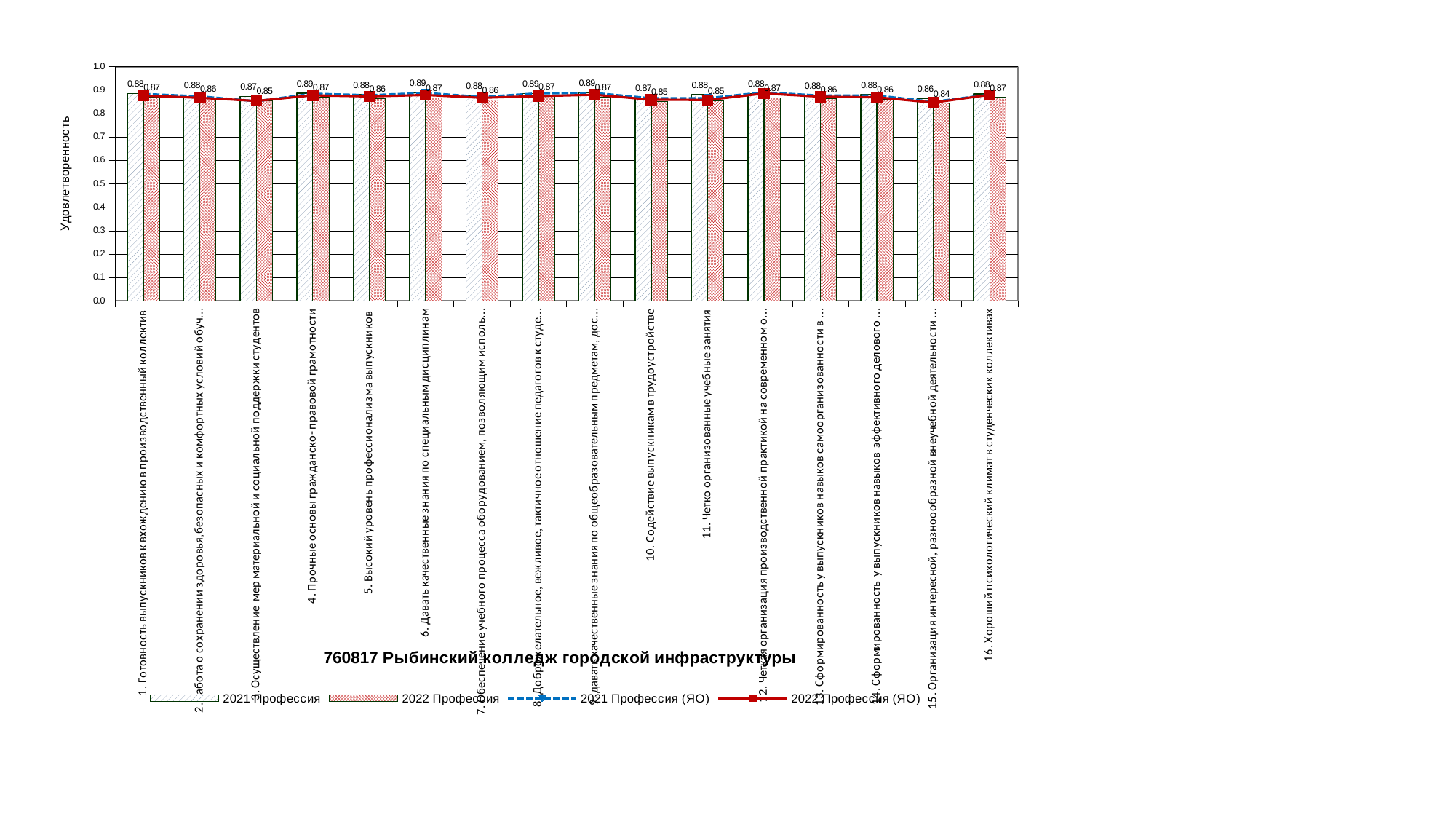
For "3. Осуществление мер материальной и социальной поддержки студентов", what is the difference between the 2021 Профессия and 2022 Профессия values? 0.02 What kind of chart is shown on the slide? A combined bar and line chart How many categories are plotted along the x axis? 16 What is the 2022 Профессия value for "10. Содействие выпускникам в трудоустройстве"? 0.85 How many series does the legend list? 4 What is the 2021 Профессия value for "4. Прочные основы гражданско-правовой грамотности"? 0.89 Is the 2021 Профессия value for "5. Высокий уровень профессионализма выпускников" greater or less than 0.8? greater For "16. Хороший психологический климат в студенческих коллективах", which is larger: the 2021 Профессия value or the 2022 Профессия value? 2021 Профессия What is the title of the chart? 760817 Рыбинский колледж городской инфраструктуры What is the label of the vertical axis? Удовлетворенность What is the 2021 Профессия value for "1. Готовность выпускников к вхождению в производственный коллектив"? 0.88 What is the lowest 2022 Профессия value shown on the chart? 0.84